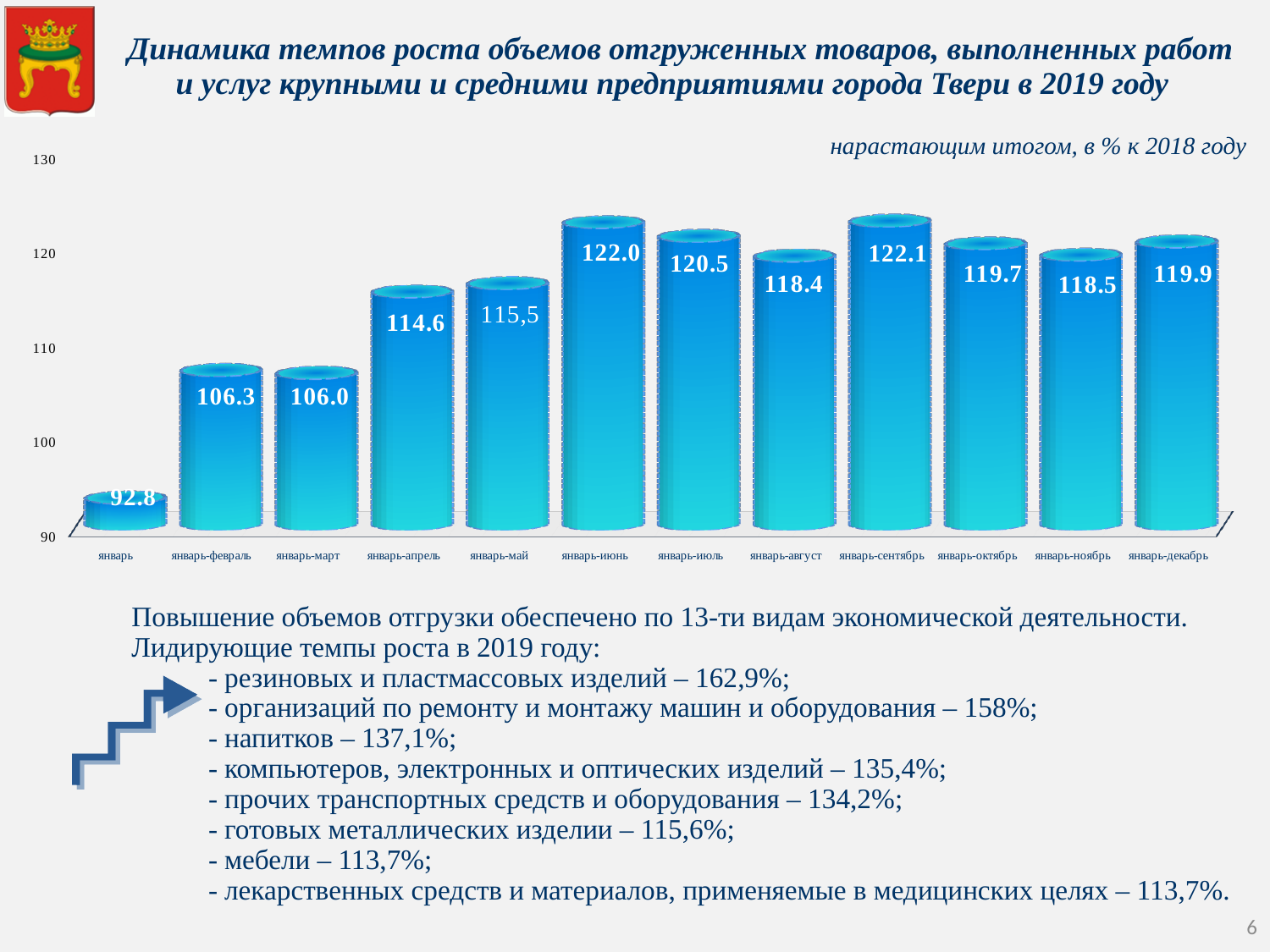
Is the value for январь-май greater or less than 110? greater What is the value for январь? 92.8 How many categories are shown on the x axis? 12 What is the value for январь-апрель? 114.6 What kind of chart is shown on the slide? bar chart Do the values rise or fall from январь to январь-апрель? rise What is the difference between the values for январь-июнь and январь-август? 3.6 Which is larger, the value for январь-июль or the value for январь-ноябрь? январь-июль What is the value for январь-сентябрь? 122.1 What is the difference between the values for январь-февраль and январь-март? 0.3 Which category has the lowest value? январь What is the value for январь-декабрь? 119.9